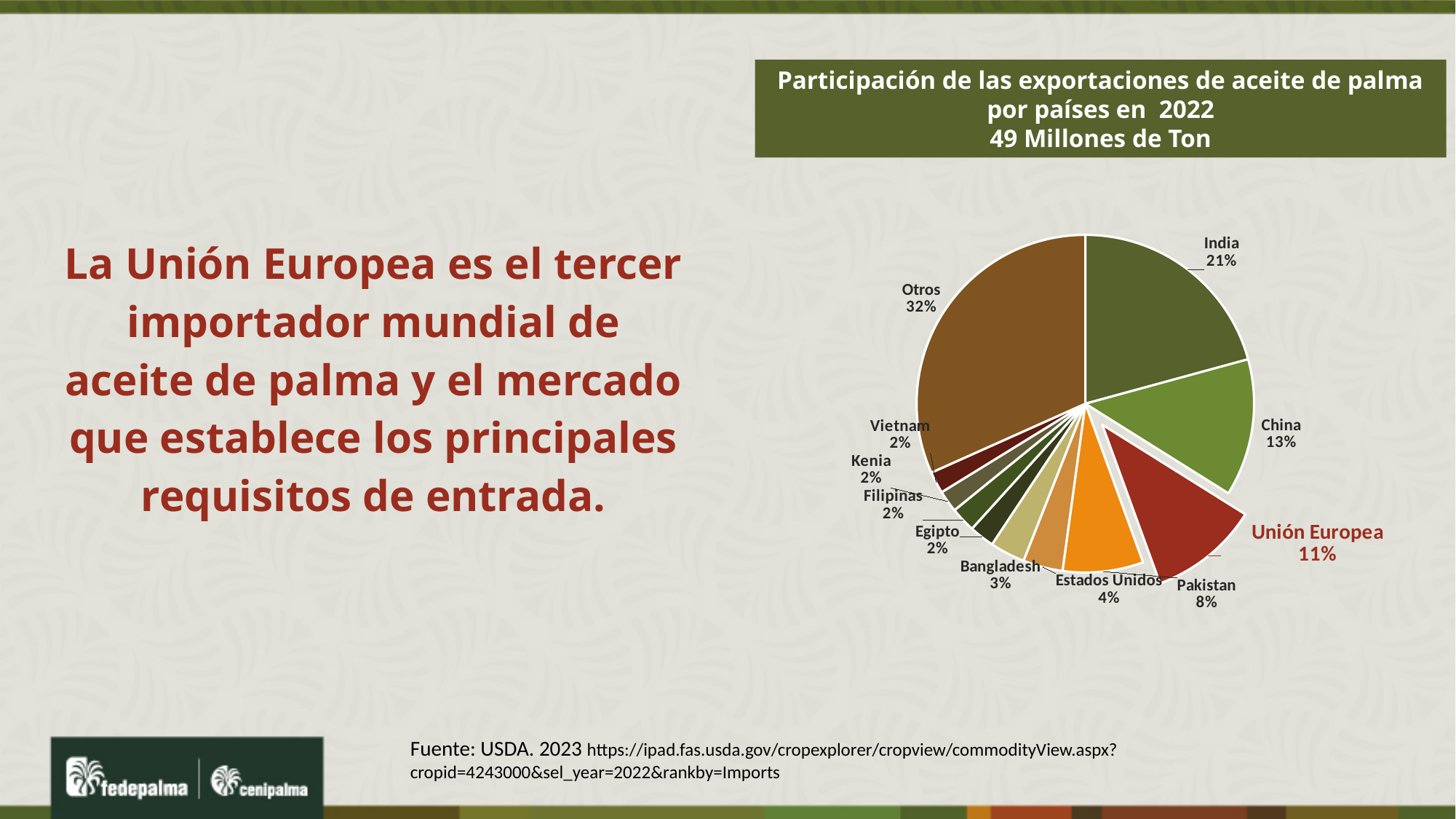
What share of the pie does China hold? 13% What is the value shown for Pakistan? 8% What kind of chart is shown on the slide? Pie chart What share of the pie does India hold? 21% What is the title of the chart? Participación de las exportaciones de aceite de palma por países en 2022 49 Millones de Ton Which is larger, the share for Unión Europea or the share for Pakistan? Unión Europea What is the difference in percentage points between India and China? 8 What is the value shown for Estados Unidos? 4% Which named country has the largest share of the pie? India Which slice of the pie is the largest? Otros What is the value shown for Unión Europea? 11% How many slices does the pie chart have? 11